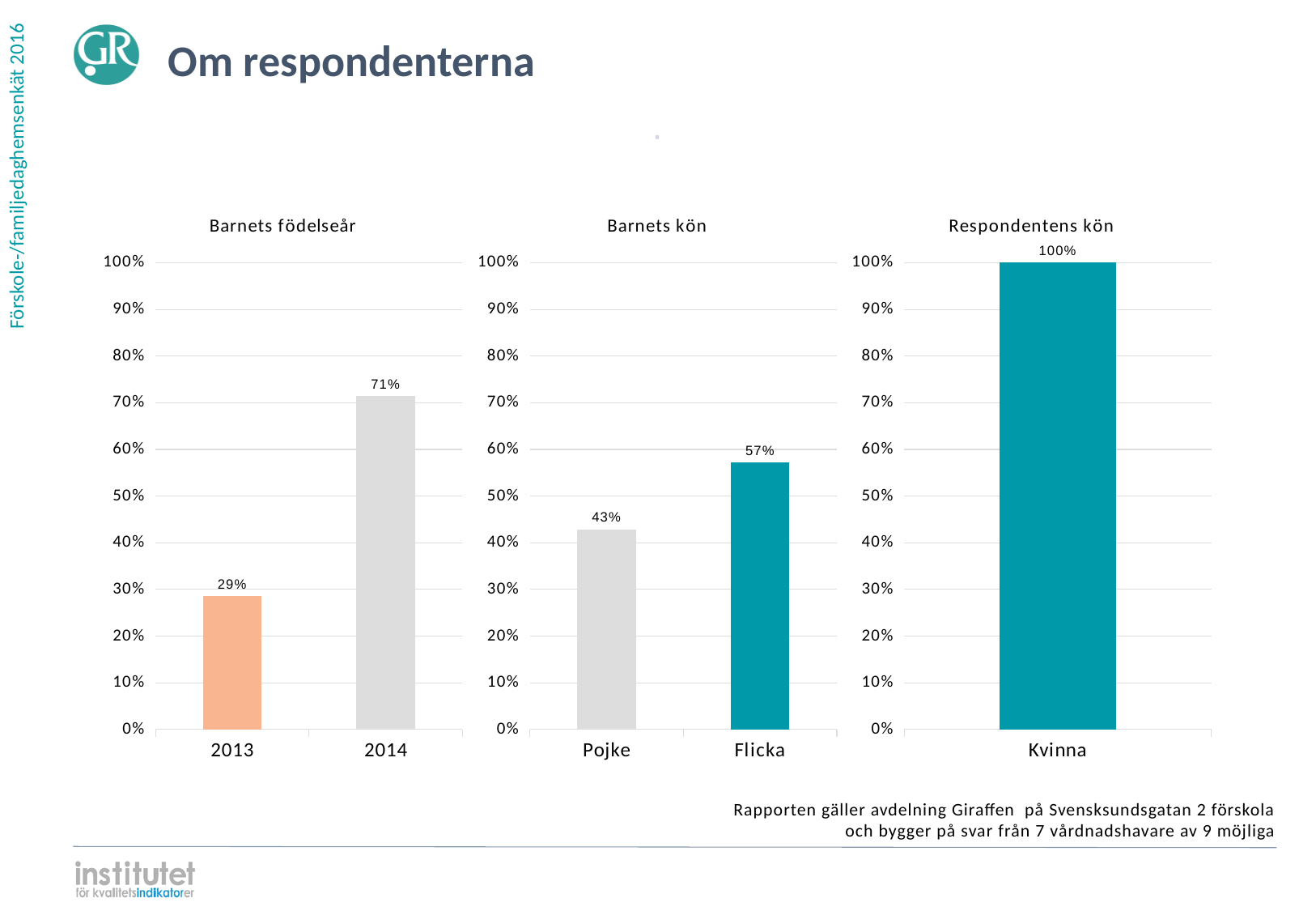
In the 'Respondentens kön' chart, what is the value for Kvinna? 100% How many categories are shown in the 'Respondentens kön' chart? 1 In the 'Barnets kön' chart, what is the value for Pojke? 43% How many charts are shown on the slide? 3 In the 'Barnets födelseår' chart, what is the value for 2013? 29% In the 'Barnets kön' chart, which category has the lower value? Pojke In the 'Barnets födelseår' chart, what is the value for 2014? 71% What kind of chart is the 'Barnets kön' chart? Bar chart In the 'Barnets kön' chart, what is the difference between Flicka and Pojke? 14 percentage points In the 'Barnets kön' chart, what is the value for Flicka? 57% In the 'Barnets födelseår' chart, what is the difference between the values for 2014 and 2013? 42 percentage points In the 'Barnets födelseår' chart, which birth year has the higher value? 2014